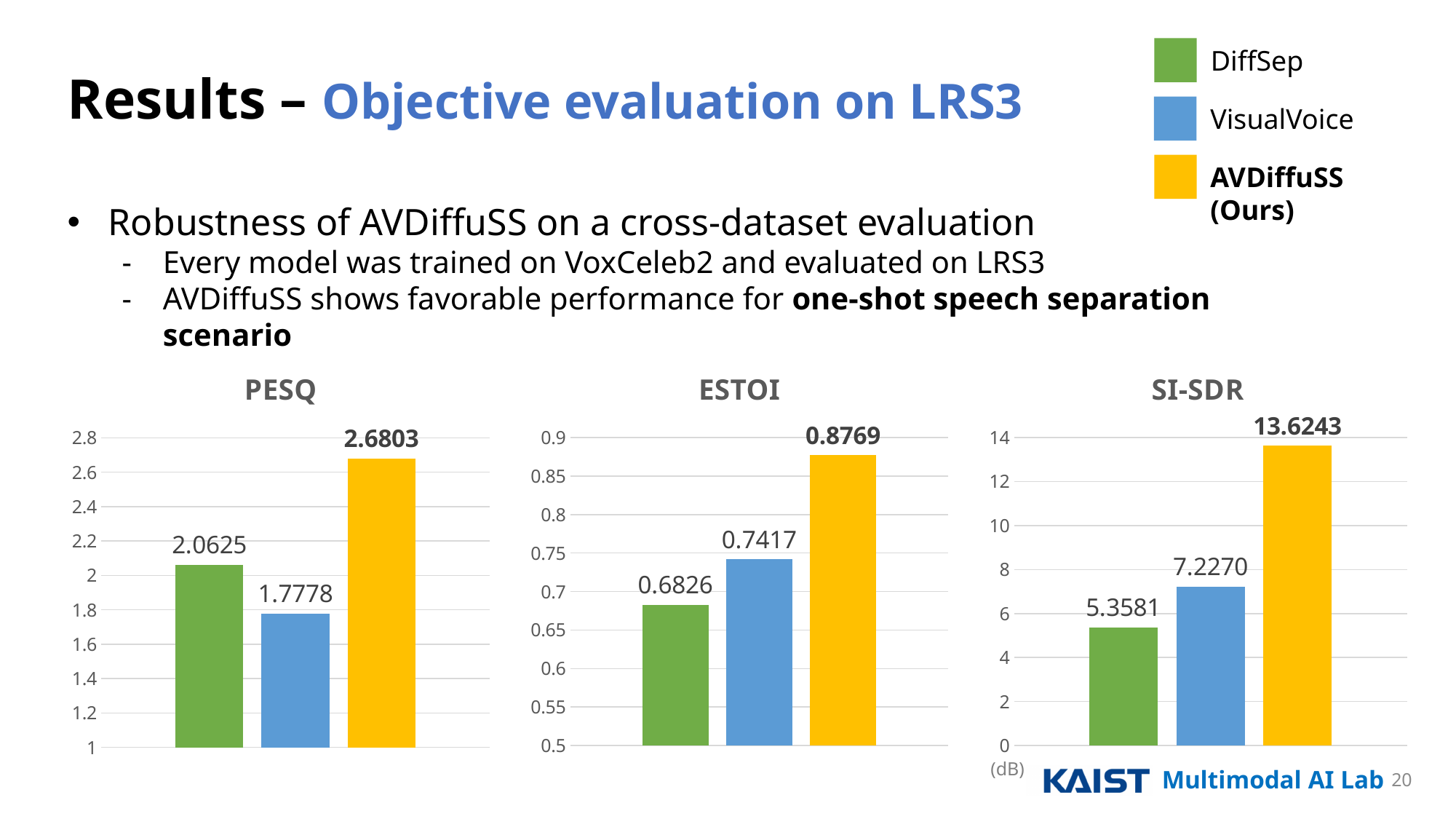
What kind of chart is the ESTOI chart? Bar chart In the PESQ chart, which model has the lowest value? VisualVoice In the PESQ chart, what is the value for AVDiffuSS (Ours)? 2.6803 How many models does the legend list? 3 In the SI-SDR chart, what is the value for VisualVoice? 7.2270 In the ESTOI chart, what is the difference between VisualVoice and DiffSep? 0.0591 In the PESQ chart, what is the value for VisualVoice? 1.7778 In the ESTOI chart, what is the value for DiffSep? 0.6826 In the SI-SDR chart, what is the difference between AVDiffuSS (Ours) and DiffSep? 8.2662 In the PESQ chart, which is larger, DiffSep or VisualVoice? DiffSep In the ESTOI chart, which model has the lowest value? DiffSep In the SI-SDR chart, which model has the highest value? AVDiffuSS (Ours)